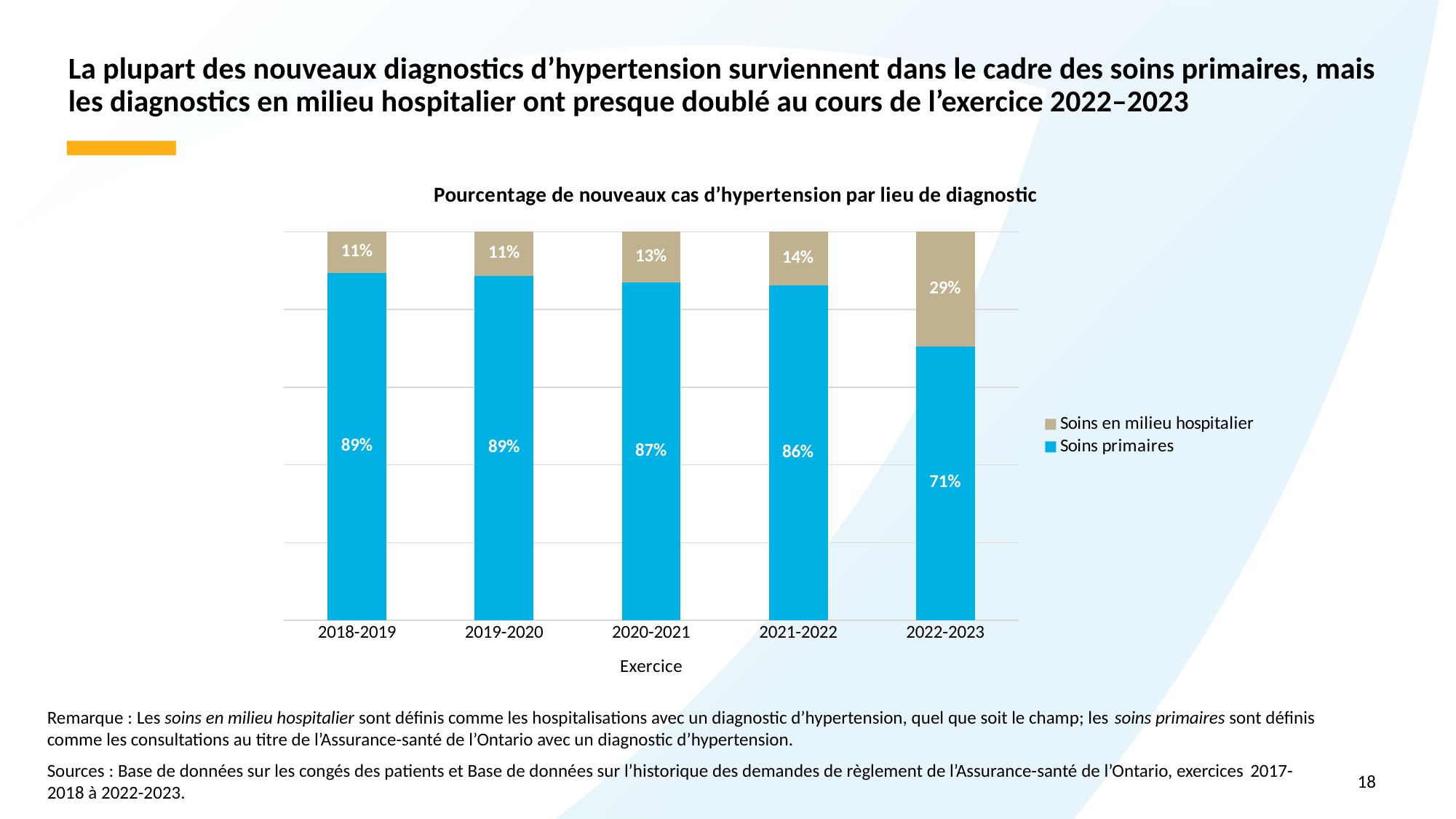
How many fiscal years are shown on the x axis? 5 Which is larger: the Soins primaires value for 2020-2021 or for 2021-2022? 2020-2021 What is the difference between the Soins en milieu hospitalier values for 2022-2023 and 2021-2022? 15% How many series does the legend list? 2 What is the Soins en milieu hospitalier value for 2021-2022? 14% What is the title of the chart? Pourcentage de nouveaux cas d’hypertension par lieu de diagnostic What percentage of new hypertension cases in 2018-2019 were diagnosed in Soins en milieu hospitalier? 11% Which fiscal year has the highest Soins en milieu hospitalier share? 2022-2023 Does the Soins primaires share rise or fall from 2018-2019 to 2022-2023? Fall What kind of chart is shown on the slide? Stacked bar chart What percentage of new hypertension cases in 2022-2023 were diagnosed in Soins primaires? 71% Which fiscal year has the lowest Soins primaires share? 2022-2023